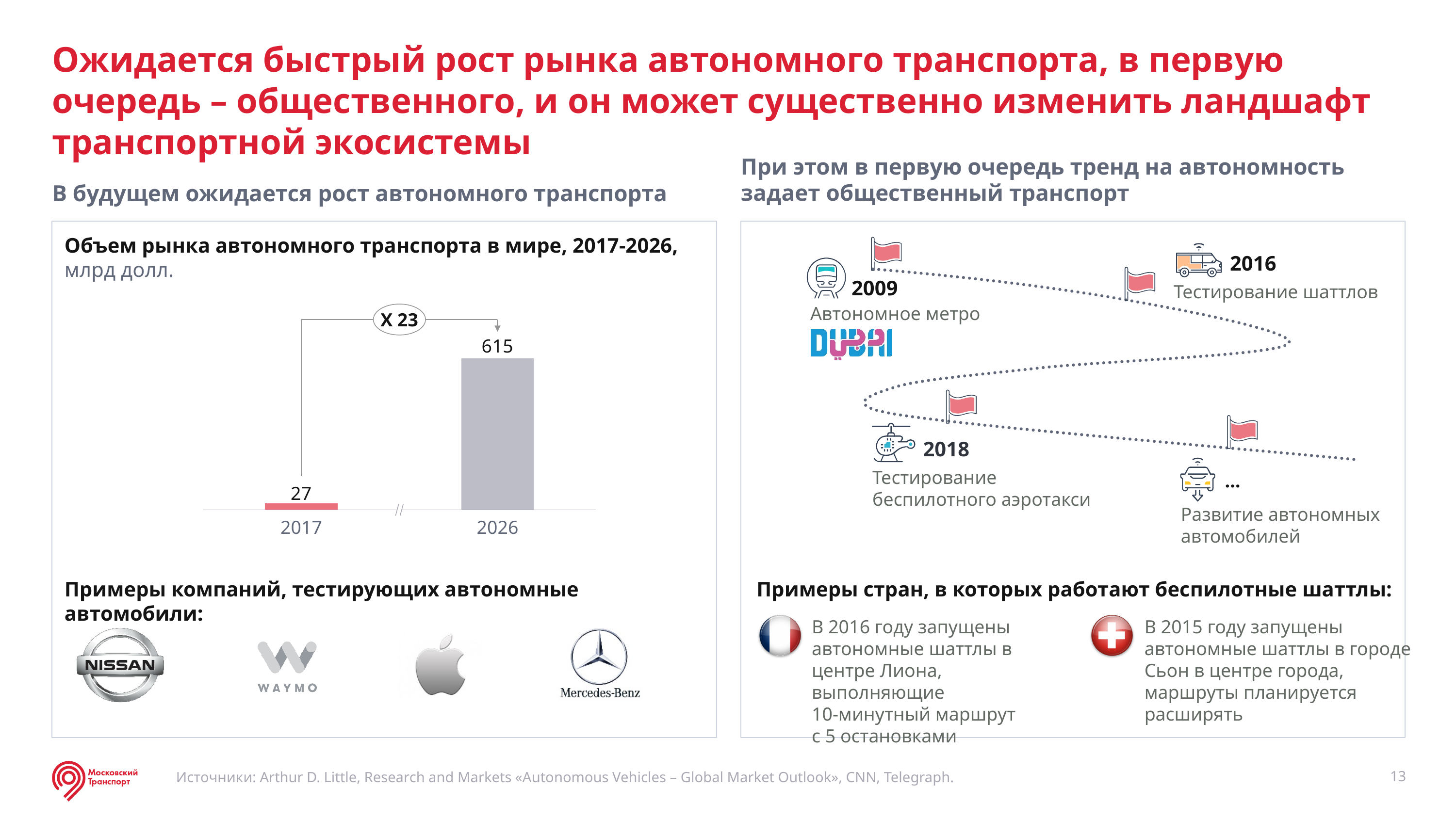
What kind of chart is used to show the global autonomous transport market volume? bar chart Which year has the higher value in the chart, 2017 or 2026? 2026 What is the value for 2017 in the chart of the global autonomous transport market? 27 What is the difference between the 2026 and 2017 values in the chart? 588 Which year has the lowest value in the chart? 2017 How many years (bars) are plotted in the chart? 2 Do the values in the chart rise or fall from 2017 to 2026? rise What is the value for 2026 in the chart of the global autonomous transport market? 615 In what units are the values of the chart expressed, according to its subtitle? млрд долл. Which year has the highest value in the chart? 2026 What growth multiplier is shown in the annotation above the bars in the chart? X 23